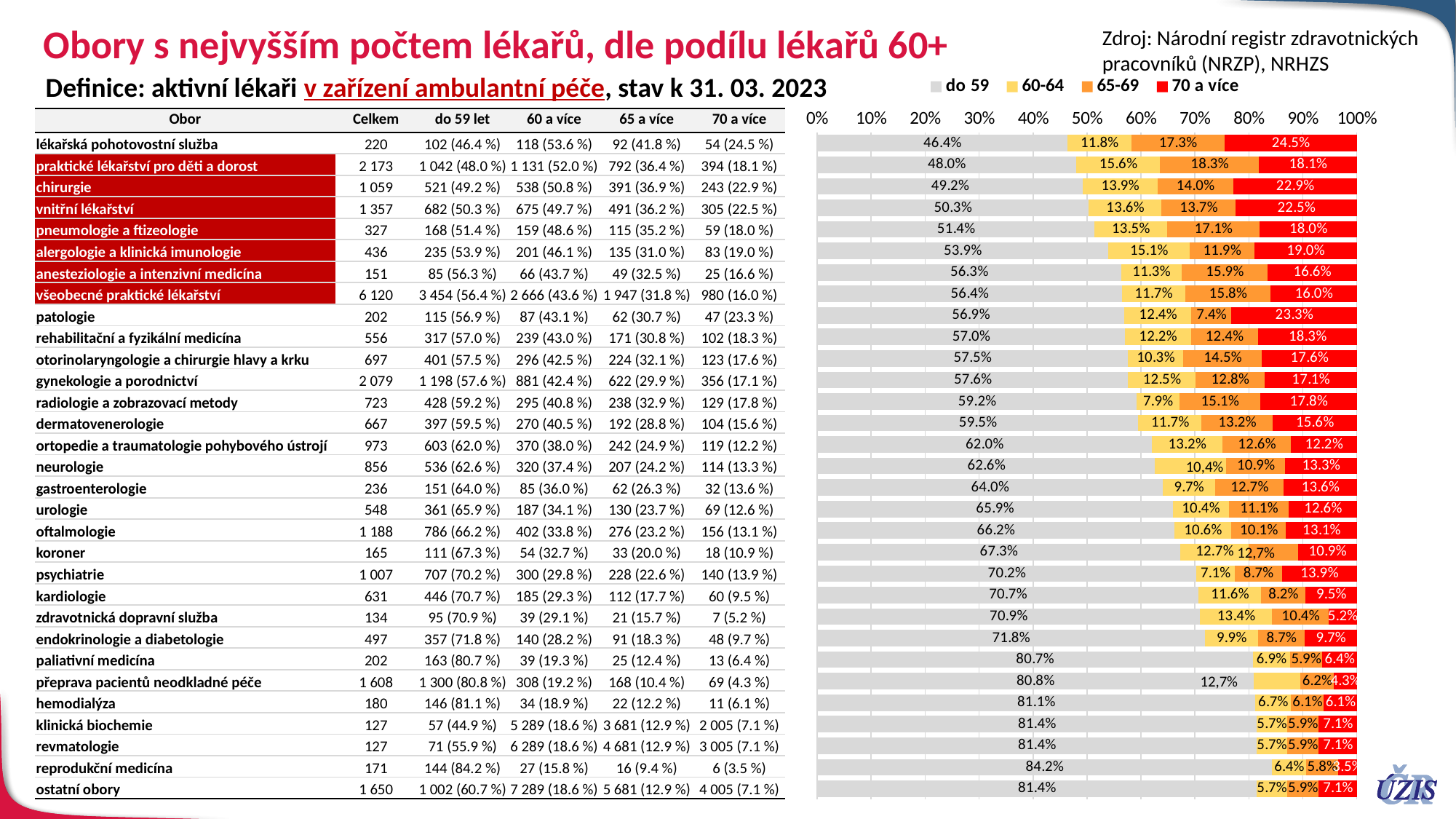
What is the largest 'do 59' value shown in the chart? 84.2% What is the smallest 'do 59' value shown in the chart? 46.4% Which colour represents the '70 a více' series in the chart legend? red In the chart, what is the '60-64' value of the second bar from the top? 15.6% Do the 'do 59' values in the chart generally increase or decrease from the top bar to the bottom bar? increase In the top bar of the chart, which segment is larger: '65-69' or '70 a více'? 70 a více In the top bar of the chart, what is the difference between the '70 a více' value and the '60-64' value? 12.7 percentage points In the chart, what is the '70 a více' value of the third bar from the top? 22.9% In the chart, what is the 'do 59' value of the top bar? 46.4% How many series does the chart legend list? 4 In the chart, what is the '70 a více' value of the top bar? 24.5% What kind of chart is shown on the right side of the slide? bar chart